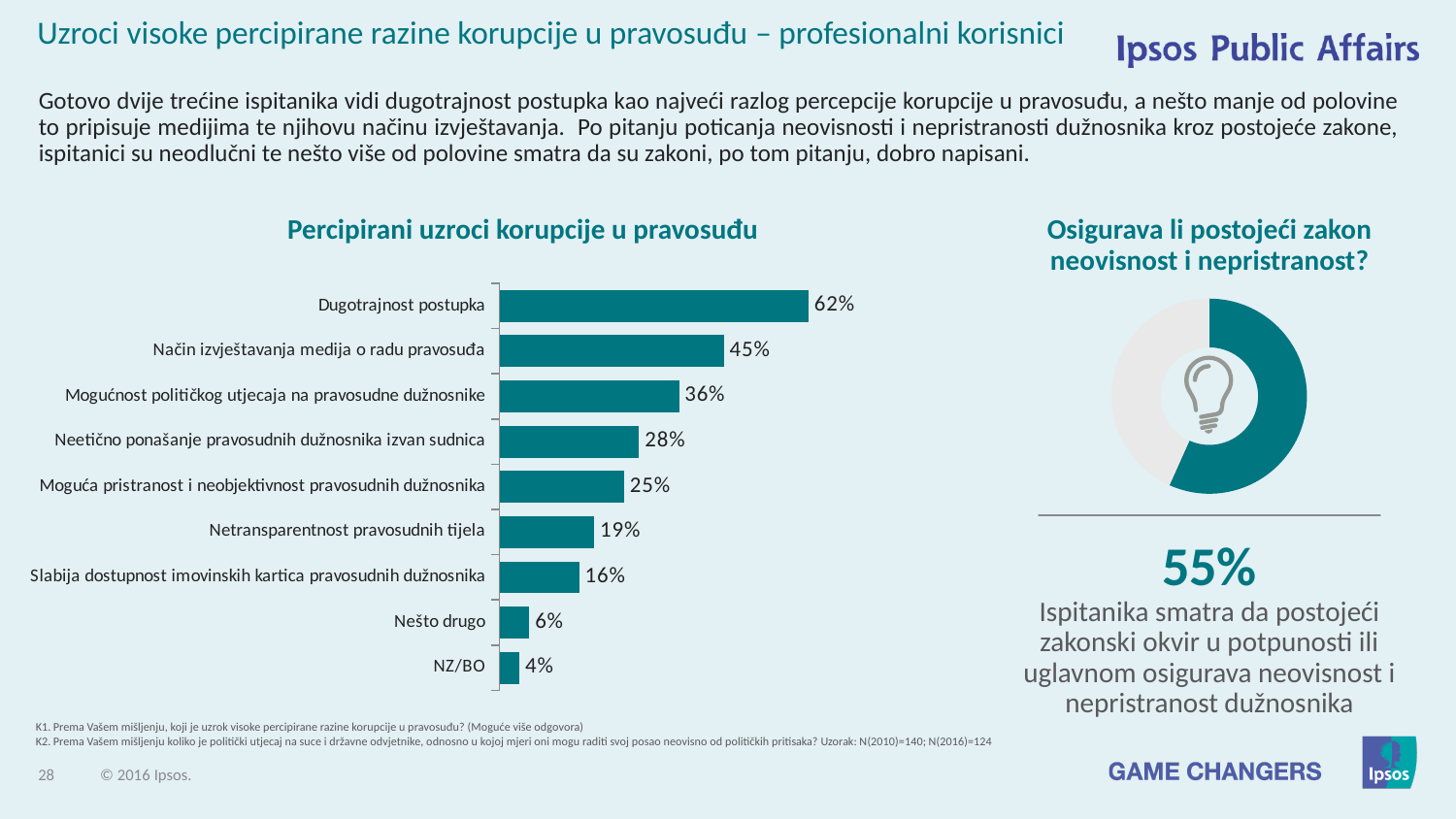
In the chart 'Percipirani uzroci korupcije u pravosuđu', which is larger: 'Neetično ponašanje pravosudnih dužnosnika izvan sudnica' or 'Moguća pristranost i neobjektivnost pravosudnih dužnosnika'? Neetično ponašanje pravosudnih dužnosnika izvan sudnica In the chart 'Osigurava li postojeći zakon neovisnost i nepristranost?', what share of respondents think the existing legal framework ensures independence and impartiality? 55% In the chart 'Percipirani uzroci korupcije u pravosuđu', what is the difference between 'Dugotrajnost postupka' and 'Način izvještavanja medija o radu pravosuđa'? 17% In the chart 'Percipirani uzroci korupcije u pravosuđu', which category has the lowest value? NZ/BO What kind of chart is 'Percipirani uzroci korupcije u pravosuđu'? Bar chart In the chart 'Percipirani uzroci korupcije u pravosuđu', which category has the highest value? Dugotrajnost postupka In the chart 'Percipirani uzroci korupcije u pravosuđu', what is the value for 'Slabija dostupnost imovinskih kartica pravosudnih dužnosnika'? 16% In the chart 'Percipirani uzroci korupcije u pravosuđu', what is the value for 'Dugotrajnost postupka'? 62% In the chart 'Percipirani uzroci korupcije u pravosuđu', what is the value for 'Netransparentnost pravosudnih tijela'? 19% In the chart 'Percipirani uzroci korupcije u pravosuđu', what is the value for 'Nešto drugo'? 6% How many categories are shown in the chart 'Percipirani uzroci korupcije u pravosuđu'? 9 What kind of chart is shown under the title 'Osigurava li postojeći zakon neovisnost i nepristranost?'? Donut chart